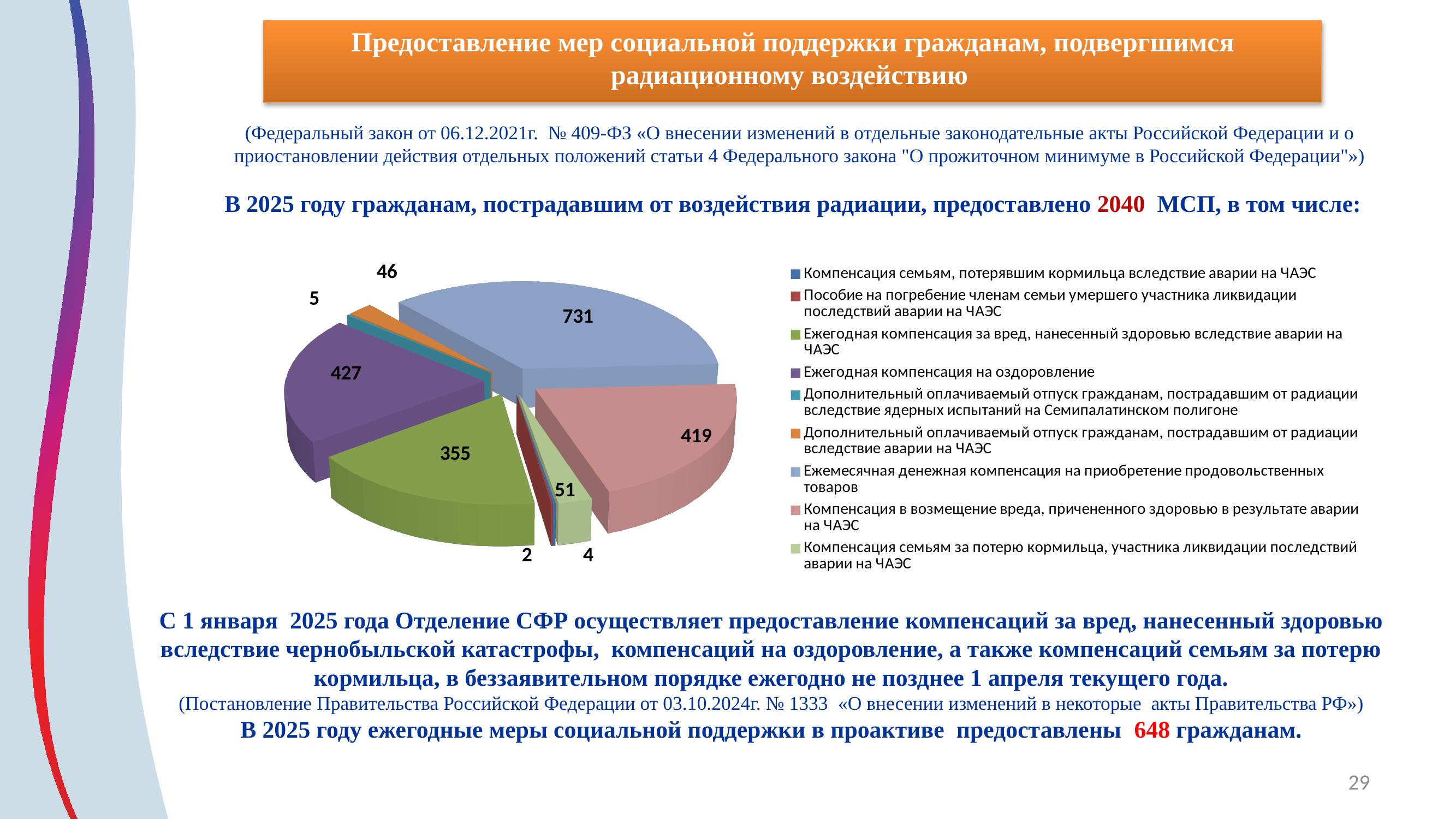
How many entries does the chart legend list? 9 What is the value for 'Дополнительный оплачиваемый отпуск гражданам, пострадавшим от радиации вследствие аварии на ЧАЭС'? 46 What is the value for 'Ежегодная компенсация за вред, нанесенный здоровью вследствие аварии на ЧАЭС'? 355 Which is larger: the value for 'Ежегодная компенсация на оздоровление' or for 'Ежегодная компенсация за вред, нанесенный здоровью вследствие аварии на ЧАЭС'? Ежегодная компенсация на оздоровление What is the value for 'Компенсация в возмещение вреда, причененного здоровью в результате аварии на ЧАЭС'? 419 What is the total number of МСП shown for 2025 according to the slide text above the chart? 2040 What is the difference between the values for 'Ежемесячная денежная компенсация на приобретение продовольственных товаров' and 'Компенсация в возмещение вреда, причененного здоровью в результате аварии на ЧАЭС'? 312 What kind of chart is shown on the slide? pie chart What is the value for 'Ежегодная компенсация на оздоровление'? 427 Which category has the largest slice in the pie chart? Ежемесячная денежная компенсация на приобретение продовольственных товаров What is the value for 'Ежемесячная денежная компенсация на приобретение продовольственных товаров'? 731 How many slices does the pie chart have? 9